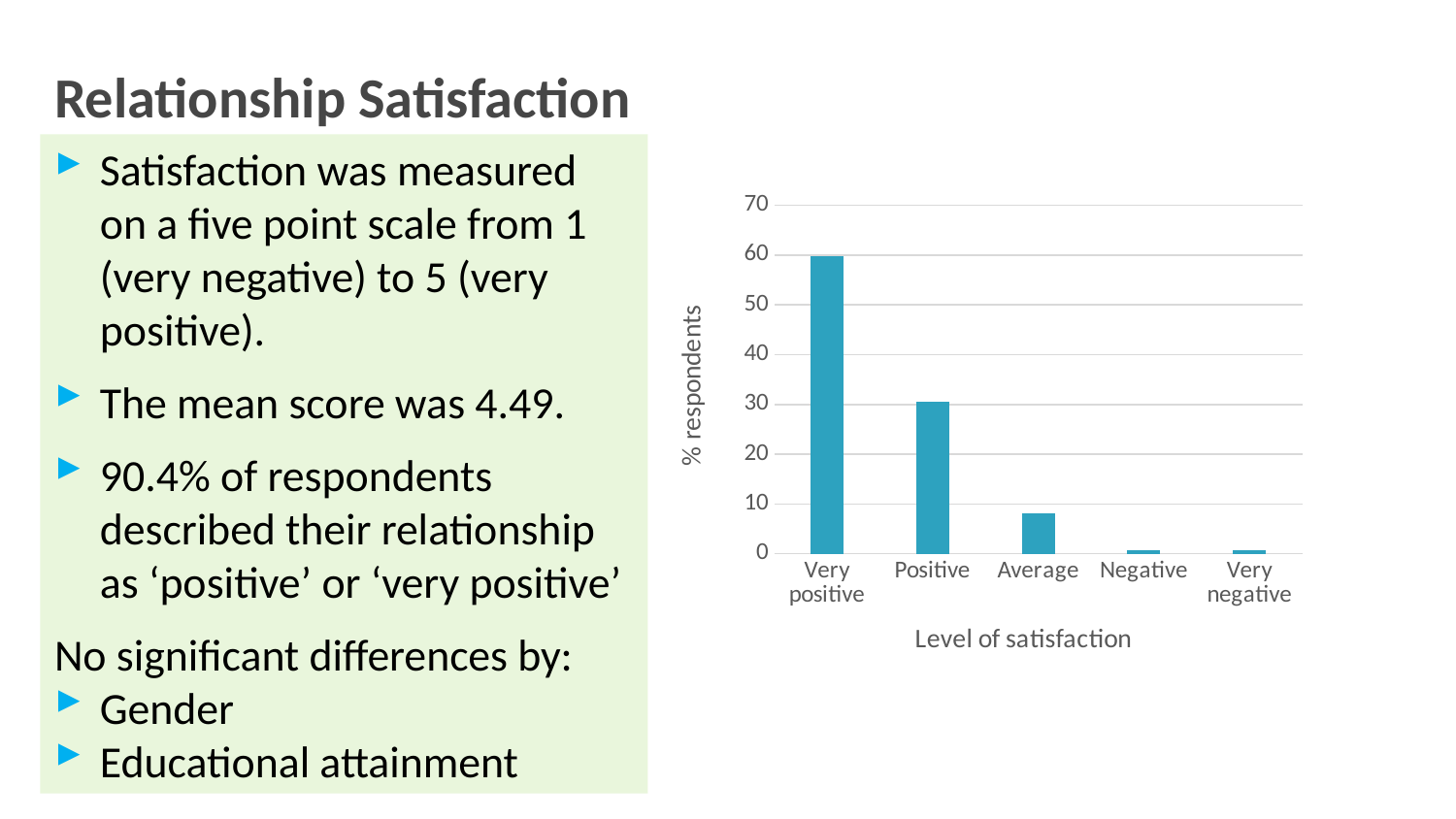
Which level of satisfaction has the highest percentage of respondents? Very positive Is the value for Positive greater or less than 40? less Is the value for Positive greater or less than 20? greater Which has a higher percentage of respondents, Very positive or Positive? Very positive What is the label on the horizontal axis of the chart? Level of satisfaction What is the label on the vertical axis of the chart? % respondents Is the value for Very positive greater or less than 50? greater How many levels of satisfaction are plotted on the x axis of the chart? 5 Do the values rise or fall moving from Very positive to Very negative along the x axis? fall Which has a higher percentage of respondents, Positive or Average? Positive What kind of chart is shown on the slide? bar chart